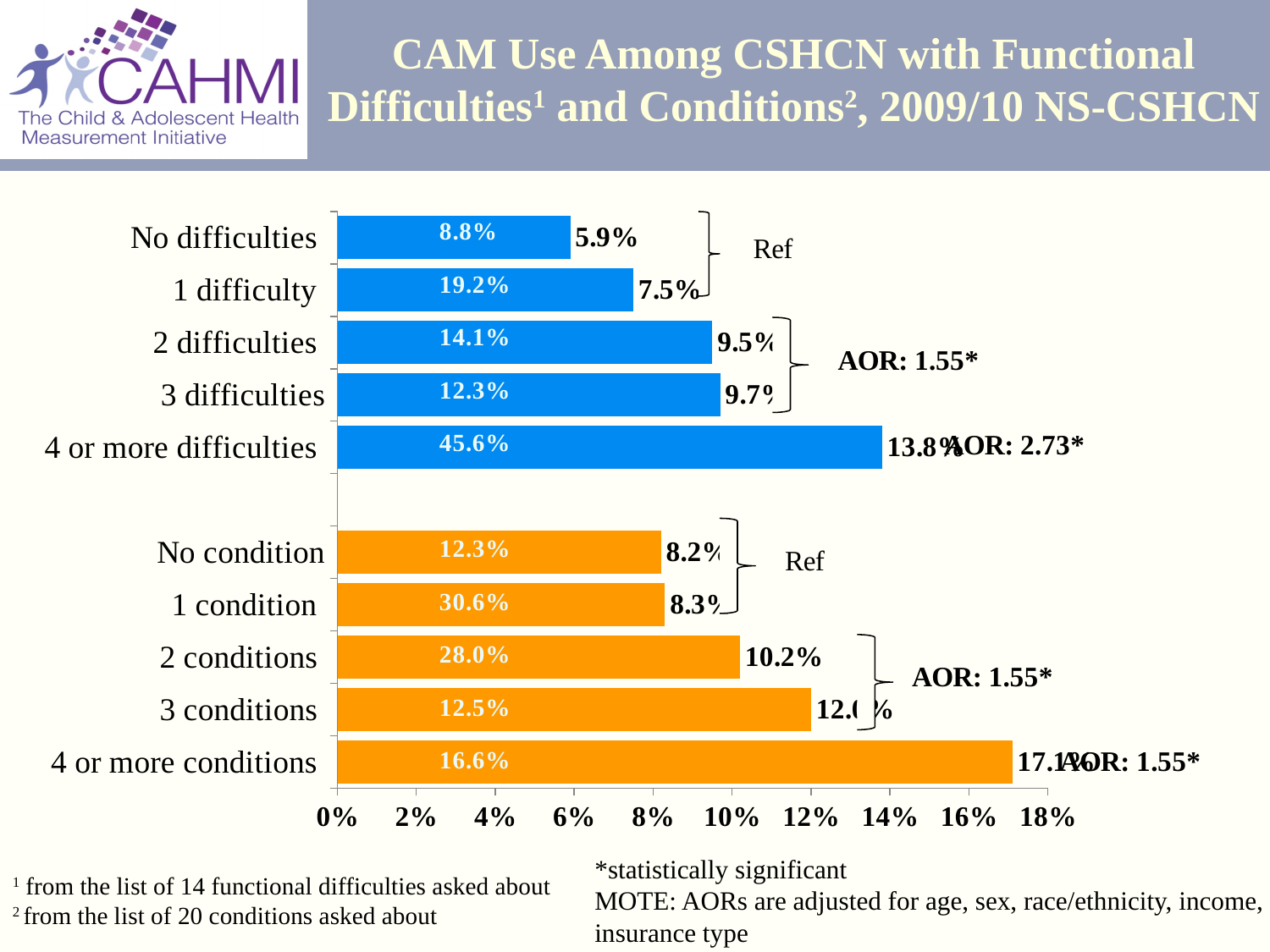
What is the value shown at the end of the bar for 2 conditions? 10.2% What is the value shown at the end of the bar for No difficulties? 5.9% Is the value for 3 conditions greater or less than 10%? greater Which category has the longest bar? 4 or more conditions What is the white label printed inside the bar for 4 or more difficulties? 45.6% How many categories are plotted on the chart? 10 What is the value shown at the end of the bar for 1 difficulty? 7.5% What is the difference between the bar values for 1 difficulty and No difficulties? 1.6 percentage points Which bar is longer: 4 or more difficulties or 2 conditions? 4 or more difficulties Which category has the shortest bar? No difficulties What is the white label printed inside the bar for 1 condition? 30.6% What type of chart is shown on the slide? Bar chart